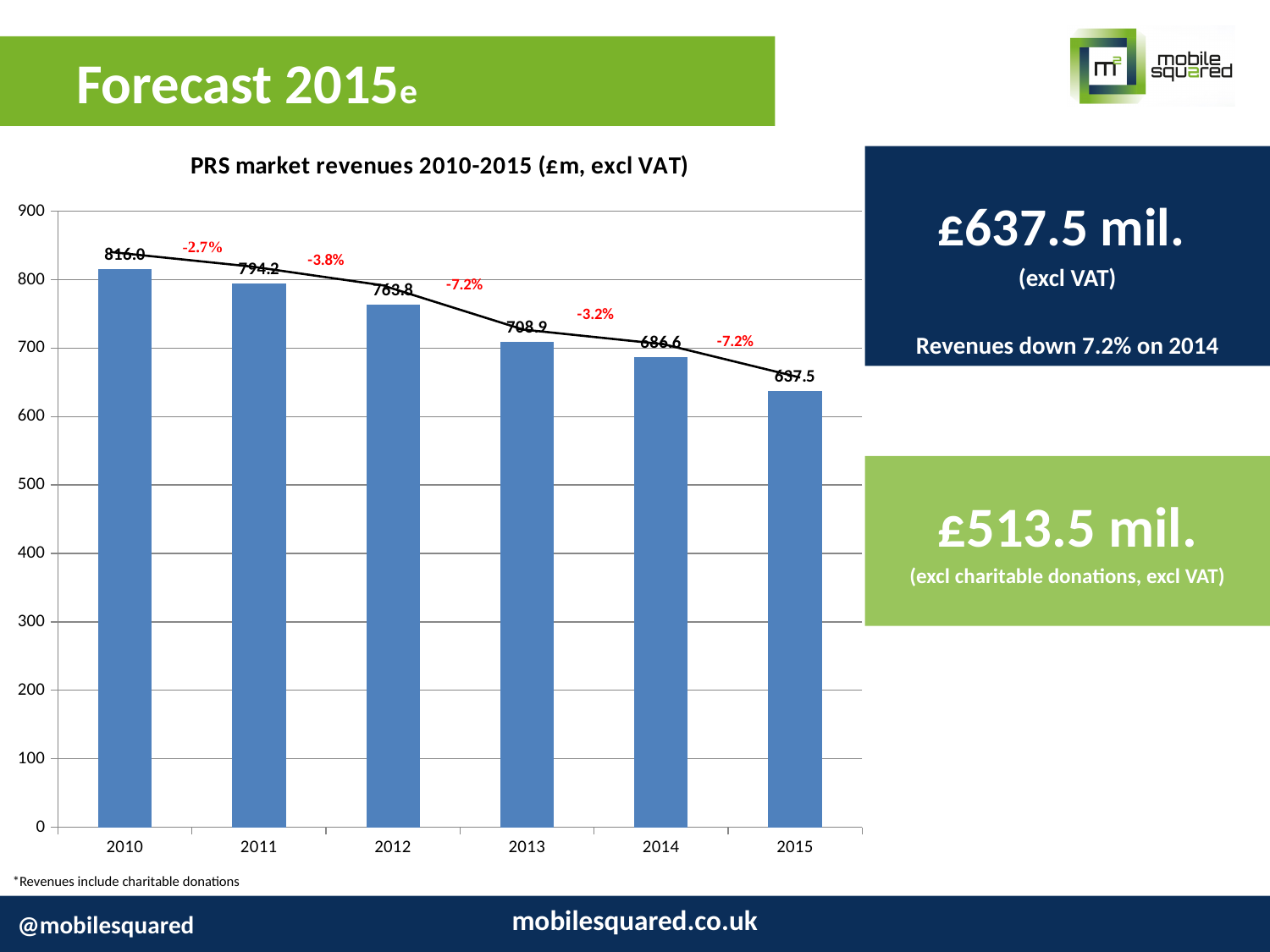
What is the PRS market revenue for 2013? 708.9 What is the difference between the 2010 and 2011 revenues? 21.8 What is the PRS market revenue for 2010? 816.0 Which year has the lowest PRS market revenue? 2015 Which year has the larger revenue, 2012 or 2014? 2012 Do the revenues rise or fall from 2010 to 2015? fall What is the PRS market revenue for 2015? 637.5 Is the value for 2013 greater or less than 700? greater How many years are shown on the x axis? 6 Which year has the highest PRS market revenue? 2010 What is the difference between the 2014 and 2015 revenues? 49.1 What is the percentage change shown between 2011 and 2012? -3.8%